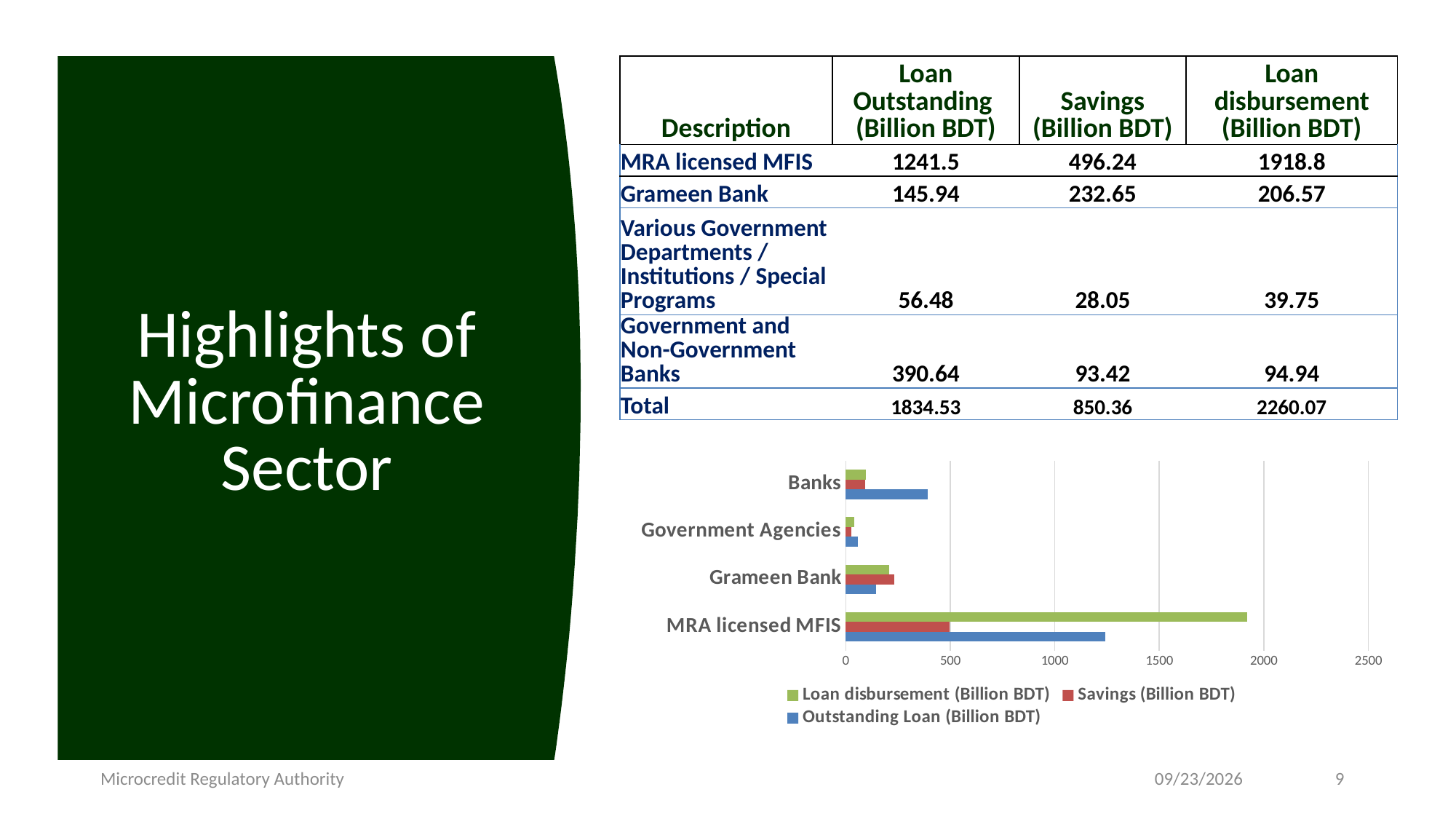
Which category has the larger Outstanding Loan (Billion BDT) bar: Banks or Grameen Bank? Banks Which category has the highest Loan disbursement (Billion BDT) bar in the chart? MRA licensed MFIS Is the Outstanding Loan (Billion BDT) value for Banks greater or less than 500? less For Grameen Bank, which is larger in the chart: Savings (Billion BDT) or Outstanding Loan (Billion BDT)? Savings (Billion BDT) Which category has the lowest Outstanding Loan (Billion BDT) bar in the chart? Government Agencies Is the Loan disbursement (Billion BDT) value for MRA licensed MFIS greater or less than 1500? greater What is the Savings (Billion BDT) value for MRA licensed MFIS? 496.24 What colour represents Savings (Billion BDT) in the chart's legend? red What is the Loan disbursement (Billion BDT) value for Grameen Bank? 206.57 What kind of chart is shown on the slide? bar chart How many series does the chart's legend list? 3 How many categories are plotted on the chart's vertical axis? 4